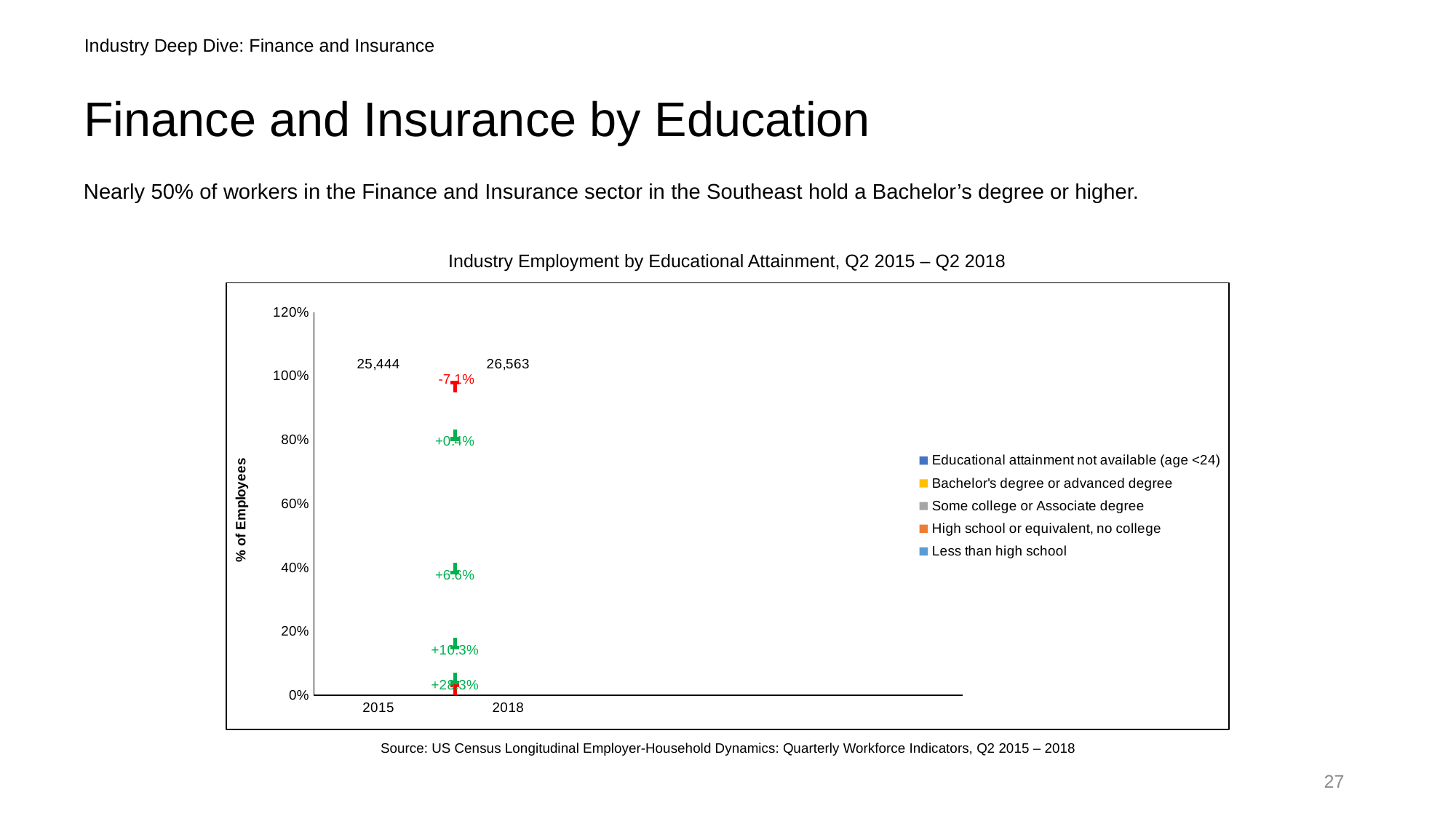
How many categories are shown on the x axis of the chart? 2 What is the largest positive change label shown between the two years on the chart? +28.3% What employment total is labelled above the 2018 category? 26,563 What is the title of the chart? Industry Employment by Educational Attainment, Q2 2015 – Q2 2018 Which two years are compared on the x axis of the chart? 2015 and 2018 Which year has the larger labelled employment total, 2015 or 2018? 2018 What is the highest value shown on the y axis of the chart? 120% What employment total is labelled above the 2015 category? 25,444 What is the label on the y axis of the chart? % of Employees How many series does the chart's legend list? 5 What is the only negative change label shown between the two years on the chart? -7.1% What is the difference between the labelled employment totals for 2018 and 2015? 1,119